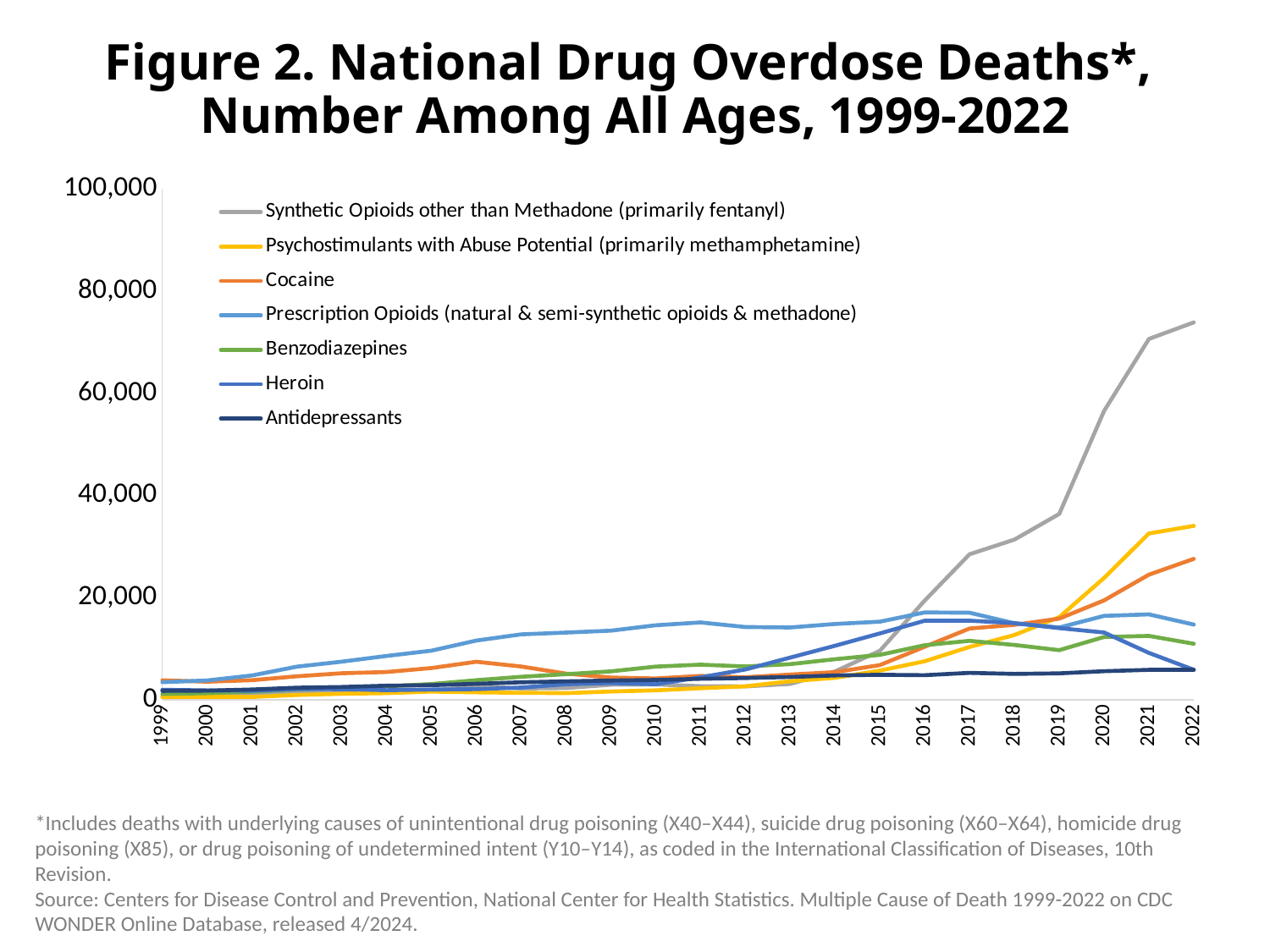
Is the value for Heroin in 2022 greater or less than 10,000? less What kind of chart is shown on the slide? line chart Do the values for Synthetic Opioids other than Methadone rise or fall from 2013 to 2022? rise In 2022, which is larger: Psychostimulants with Abuse Potential or Cocaine? Psychostimulants with Abuse Potential Which series has the highest value in 2022? Synthetic Opioids other than Methadone (primarily fentanyl) What colour is the Cocaine line in the chart? orange How many years are shown along the x axis? 24 Is the value for Synthetic Opioids other than Methadone in 2022 greater or less than 60,000? greater Is the value for Psychostimulants with Abuse Potential in 2022 greater or less than 40,000? less In 2022, which is larger: Cocaine or Benzodiazepines? Cocaine Do the values for Heroin rise or fall from 2017 to 2022? fall How many series does the legend list? 7